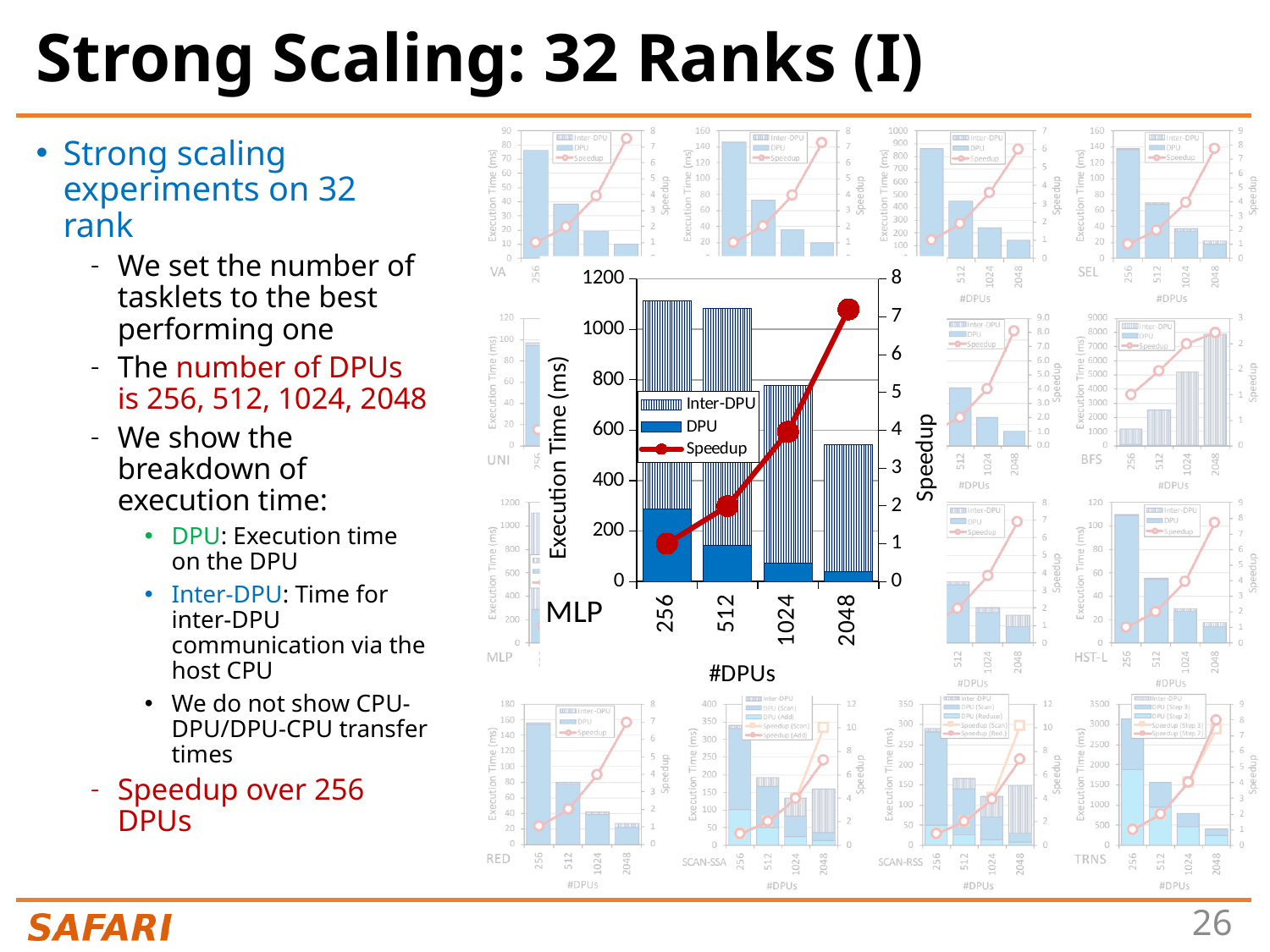
In the MLP chart, which has the larger total execution time, 512 DPUs or 1024 DPUs? 512 DPUs In the MLP chart, does the total execution time rise or fall as the number of DPUs increases from 256 to 2048? fall In the MLP chart, is the total execution time for 2048 DPUs greater or less than 600 ms? less In the MLP chart, what is the label of the right-hand vertical axis? Speedup In the MLP chart, does the speedup rise or fall as the number of DPUs increases? rise What kind of chart is the large MLP chart in the centre of the slide? bar chart with a line for speedup In the MLP chart, is the total execution time for 256 DPUs greater or less than 1000 ms? greater In the MLP chart, how many #DPUs categories are shown on the x axis? 4 In the MLP chart, is the speedup for 2048 DPUs greater or less than 6? greater In the MLP chart, what is the speedup for 256 DPUs? 1 In the MLP chart, how many series does the legend list? 3 In the MLP chart, which #DPUs value has the highest speedup? 2048